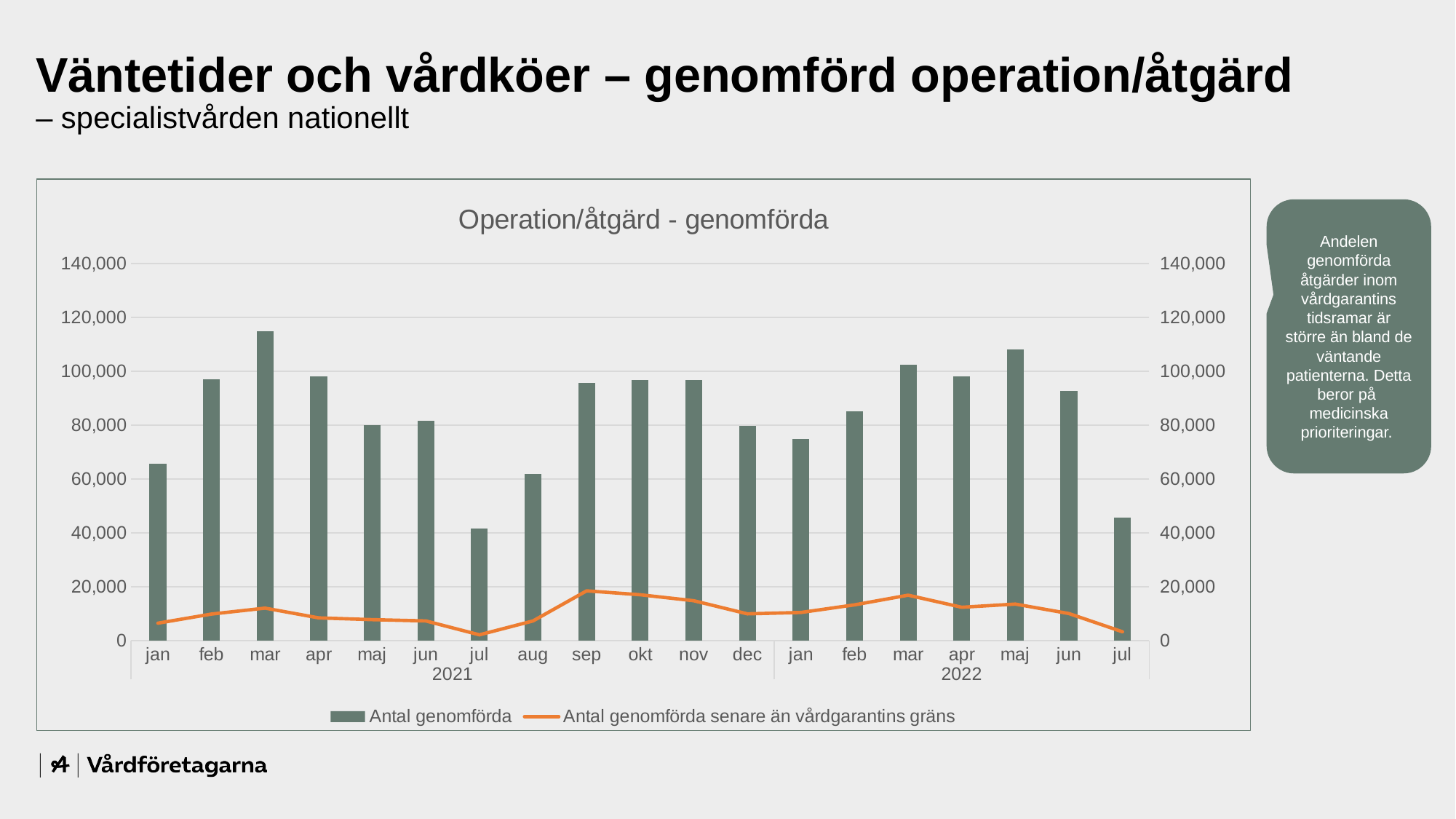
Is the value for Antal genomförda in maj 2022 greater or less than 100,000? greater In which month does the line Antal genomförda senare än vårdgarantins gräns reach its highest point? sep 2021 Which is larger, Antal genomförda in feb 2021 or in jan 2022? feb 2021 Is the value for Antal genomförda in mar 2021 greater or less than 100,000? greater How many series does the legend list? 2 What is the title of the chart? Operation/åtgärd - genomförda Which month has the highest bar for Antal genomförda? mar 2021 How many months are plotted along the x axis? 19 What type of chart is shown on the slide? Combined bar and line chart Is the value for Antal genomförda in jul 2021 greater or less than 60,000? less Which month has the lowest bar for Antal genomförda? jul 2021